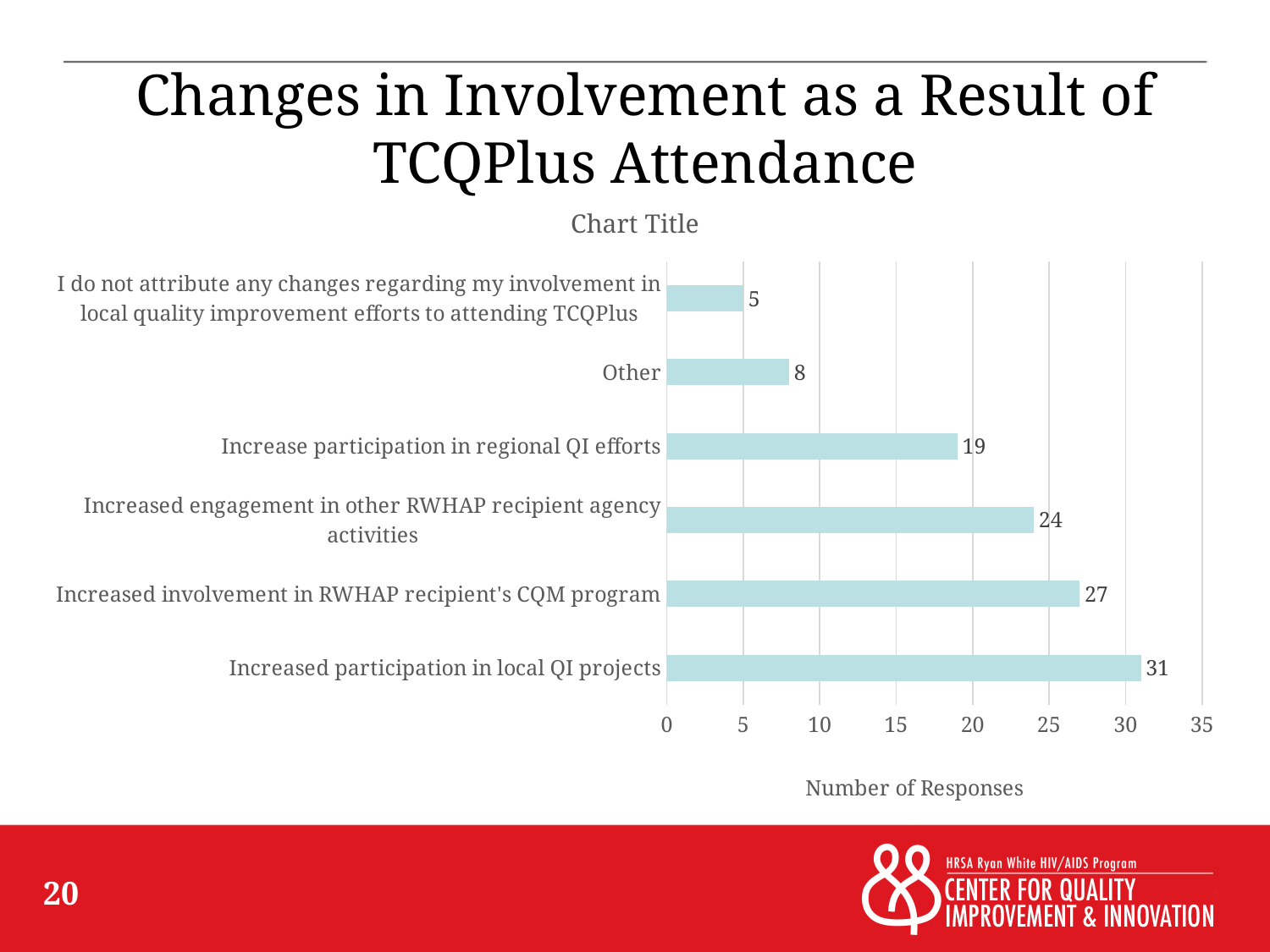
Which has more responses: "Other" or "Increase participation in regional QI efforts"? Increase participation in regional QI efforts Which category has the highest number of responses? Increased participation in local QI projects How many responses are shown for "Increase participation in regional QI efforts"? 19 How many responses are shown for "Increased participation in local QI projects"? 31 How many categories are shown in the chart? 6 What is the value for "Other"? 8 Which category has the lowest number of responses? I do not attribute any changes regarding my involvement in local quality improvement efforts to attending TCQPlus What is the label of the horizontal axis? Number of Responses What is the difference between the values for "Increased involvement in RWHAP recipient's CQM program" and "Increased engagement in other RWHAP recipient agency activities"? 3 What is the difference between the highest and lowest values in the chart? 26 What kind of chart is shown on the slide? Bar chart Is the value for "Increased engagement in other RWHAP recipient agency activities" greater or less than 20? greater